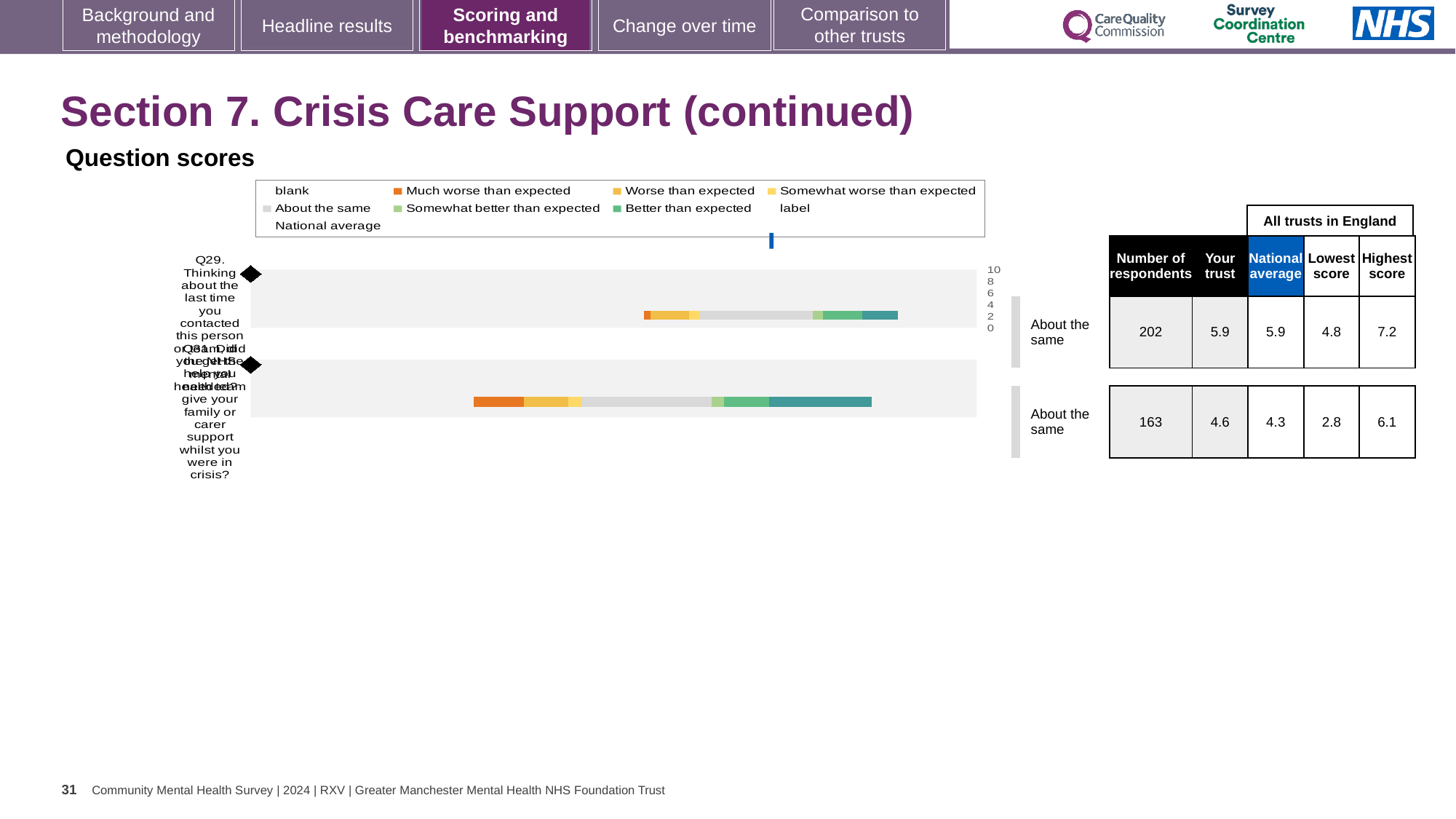
According to the table next to the chart, what is the 'Your trust' score for Q31? 4.6 What kind of chart is shown under 'Question scores'? bar chart Which legend entry is shown in orange? Much worse than expected According to the table next to the chart, what is the highest score among all trusts in England for Q31? 6.1 What benchmark label is shown for Q31 next to the chart? About the same According to the table next to the chart, how many respondents answered Q29? 202 According to the table next to the chart, what is the lowest score among all trusts in England for Q29? 4.8 What is the difference between the 'Your trust' score and the national average for Q31? 0.3 Which question had more respondents, Q29 or Q31? Q29 How many question bars are plotted in the chart? 2 What is the difference between the highest and lowest scores for Q29? 2.4 According to the table next to the chart, what is the national average for Q29? 5.9